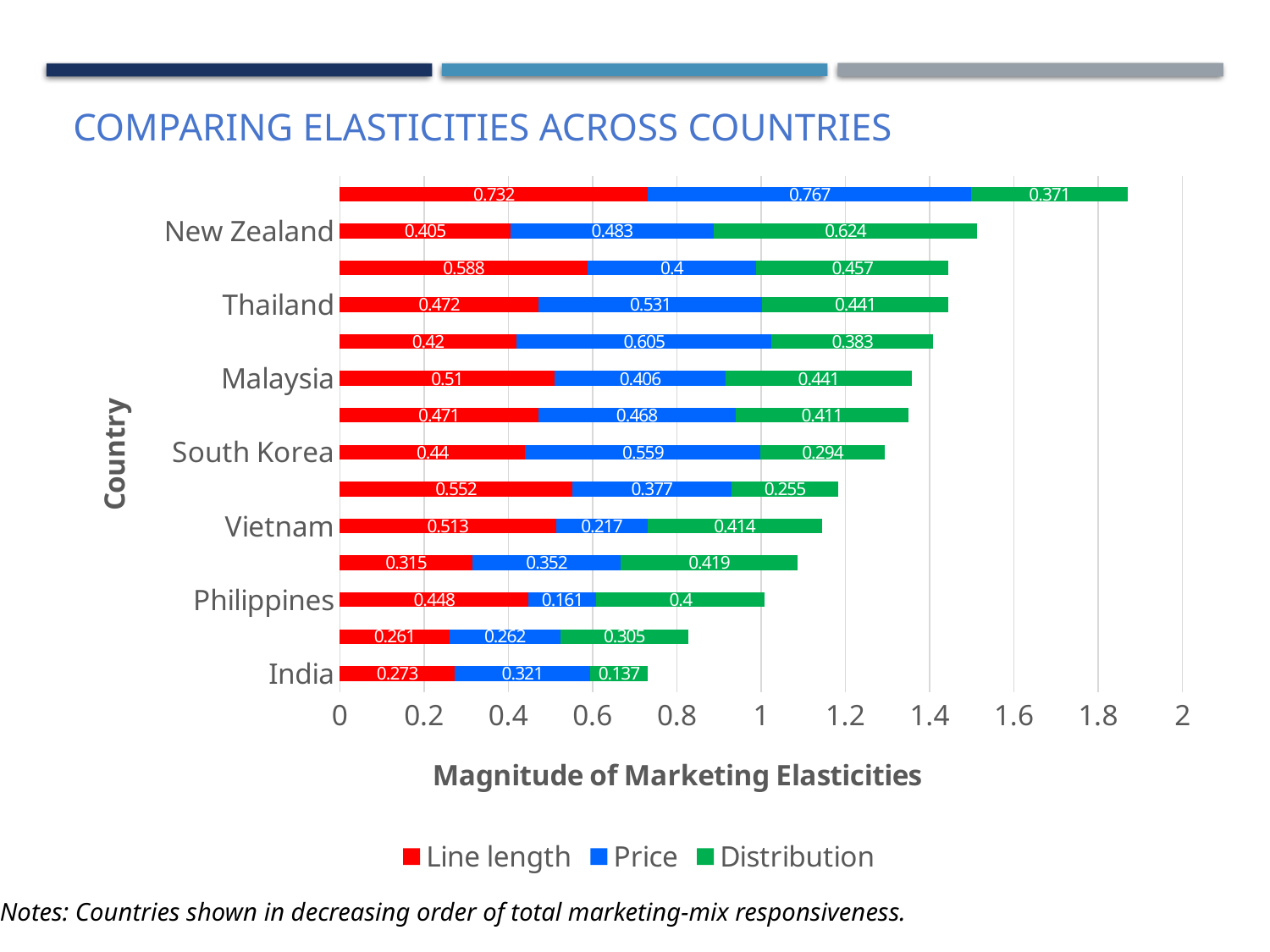
What is the title of the horizontal axis? Magnitude of Marketing Elasticities What is the Distribution elasticity value for India? 0.137 Which country has the highest Distribution elasticity value? New Zealand What is the Line length elasticity value for Malaysia? 0.51 What is the total of the stacked bar for India? 0.731 What is the Price elasticity value for the Philippines? 0.161 What is the total of the stacked bar for New Zealand? 1.512 For Thailand, how much larger is the Price value than the Line length value? 0.059 What is the Price elasticity value for New Zealand? 0.483 For Vietnam, which is larger: the Line length value or the Distribution value? Line length Which country has the lowest Price elasticity value? Philippines How many series does the legend list? 3